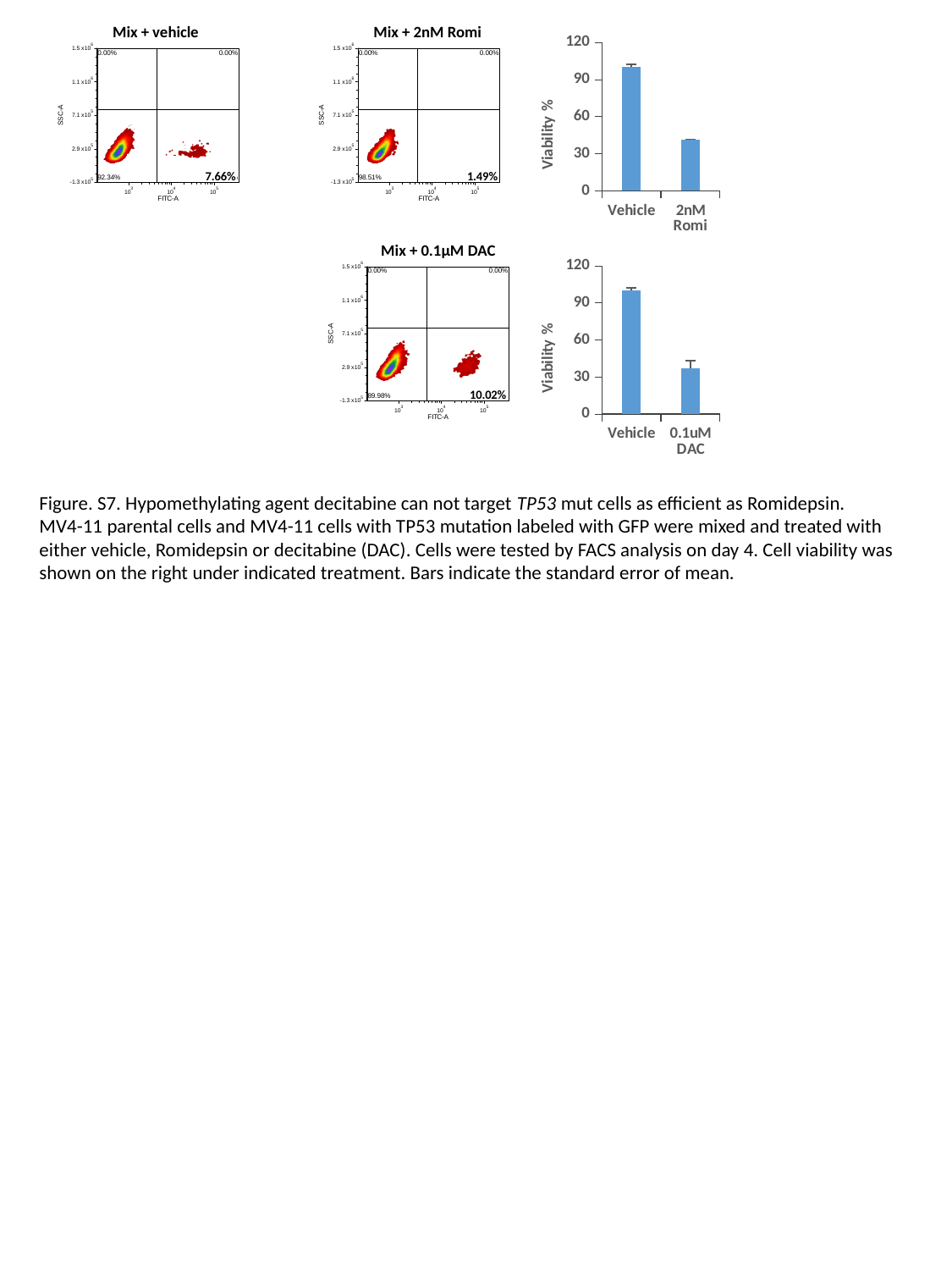
In the top-right Viability % bar chart, is the value for 2nM Romi greater or less than 60? less In the Mix + vehicle FACS plot, what percentage is printed in the lower-right quadrant? 7.66% In the top-right Viability % bar chart, which bar is higher, Vehicle or 2nM Romi? Vehicle In the Mix + 2nM Romi FACS plot, what percentage is printed in the lower-right quadrant? 1.49% What kind of chart is the top-right chart with the y axis labelled Viability %? bar chart In the top-right Viability % bar chart, how many bars are plotted? 2 What is the label on the x axis of the FACS scatter plots? FITC-A In the top-right Viability % bar chart, is the value for Vehicle greater or less than 90? greater In the bottom-right Viability % bar chart, which category has the lowest value? 0.1uM DAC In the Mix + 0.1µM DAC FACS plot, what percentage is printed in the lower-left quadrant? 89.98% In the bottom-right Viability % bar chart, is the value for 0.1uM DAC greater or less than 60? less Across the three FACS plots, which one shows the highest lower-right quadrant percentage? Mix + 0.1µM DAC